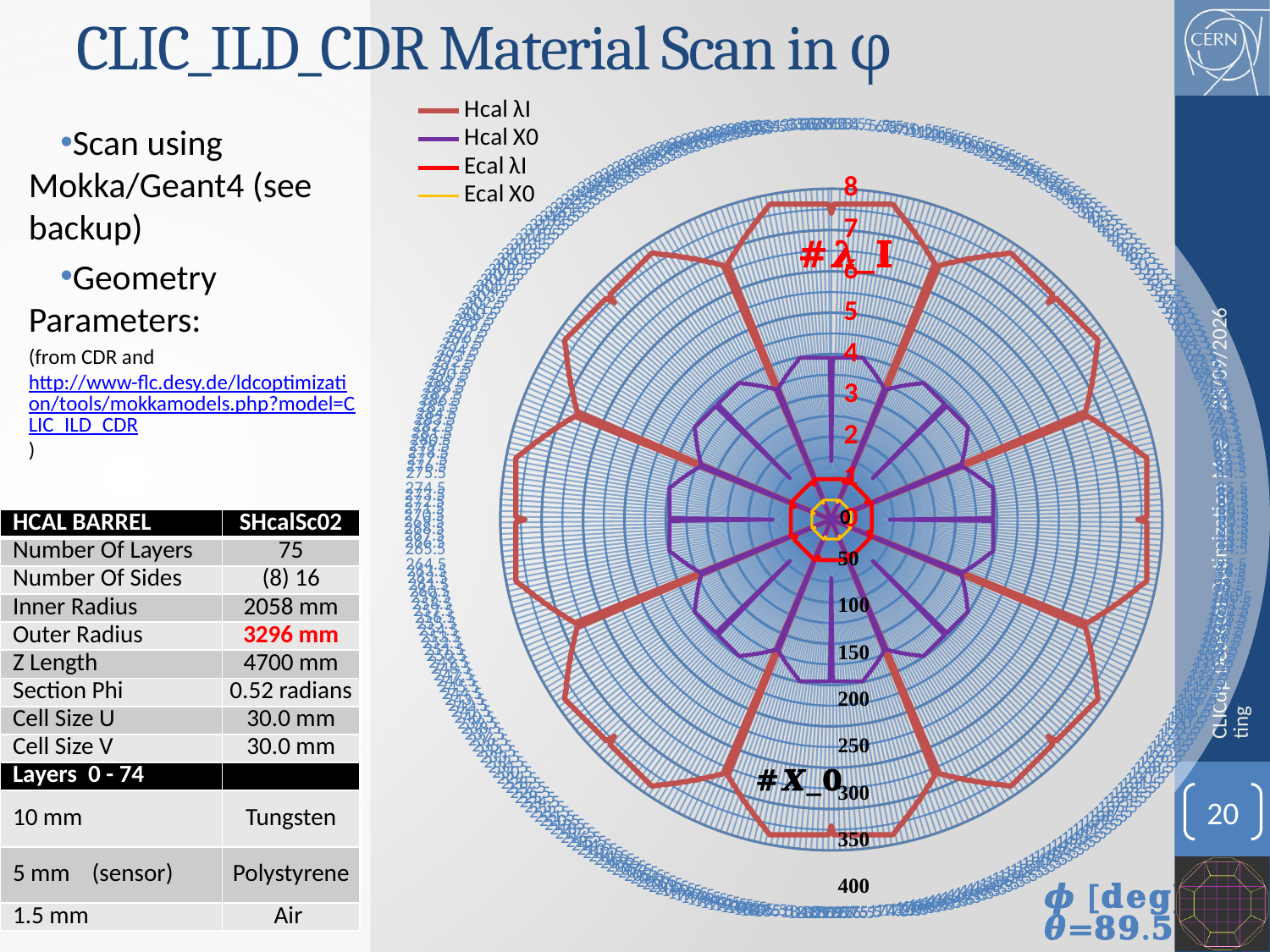
How many series does the chart legend list? 4 Which of the four series lies closest to the centre of the chart? Ecal X0 Which of the four series extends furthest from the centre of the chart? Hcal λI What kind of chart is shown on the slide? radar chart Is the value of the Hcal λI series greater or less than 4 on the λI axis? greater Which series is drawn in purple in the chart? Hcal X0 Which series is drawn in yellow in the chart? Ecal X0 Which series extends further from the centre of the chart, Hcal X0 or Ecal X0? Hcal X0 Is the value of the Ecal X0 series greater or less than 50 on the X0 axis? less Is the value of the Ecal λI series greater or less than 2 on the λI axis? less Which series extends further from the centre of the chart, Hcal λI or Ecal λI? Hcal λI